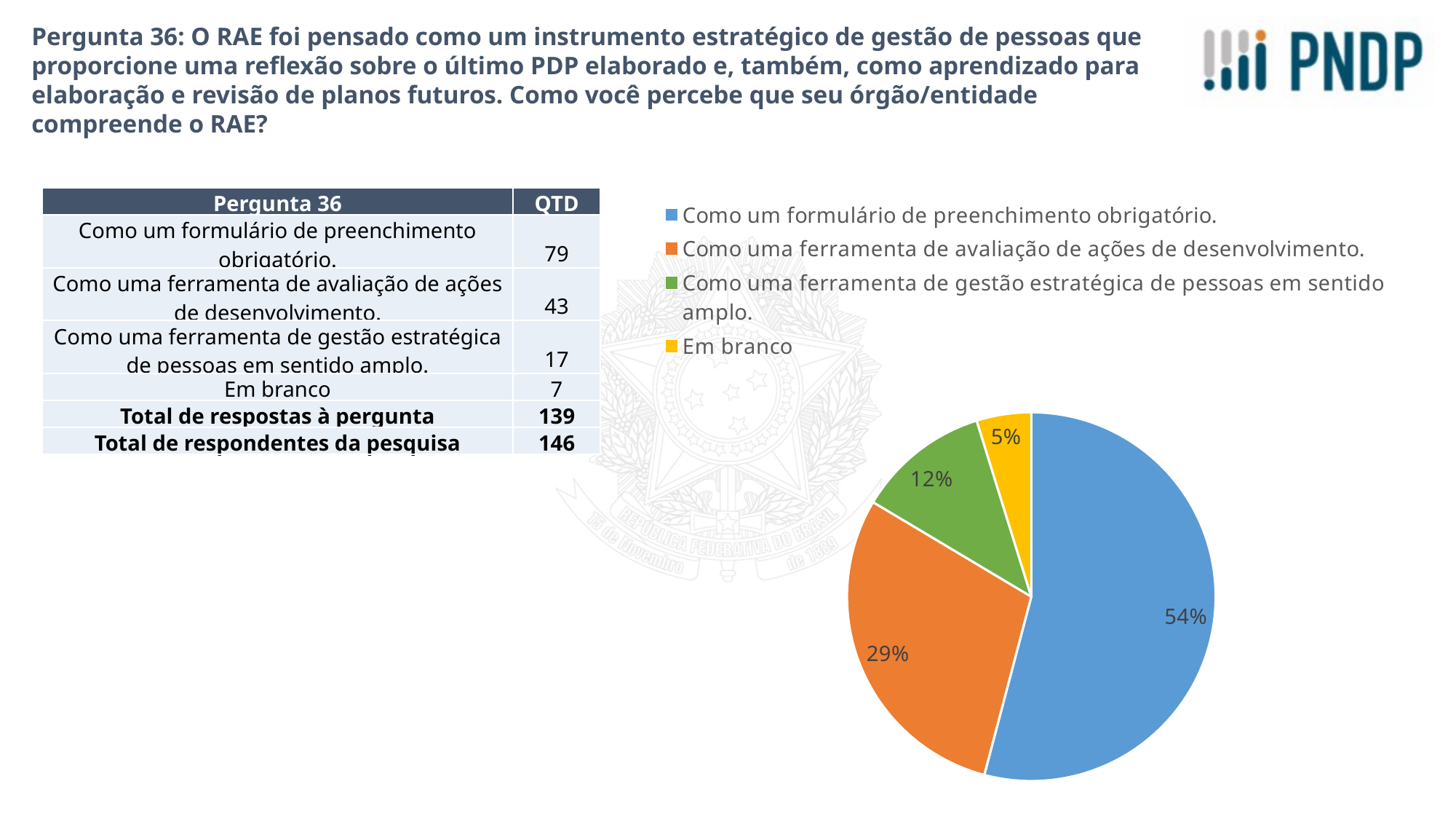
What is the difference in percentage points between the "Como um formulário de preenchimento obrigatório." slice and the "Como uma ferramenta de avaliação de ações de desenvolvimento." slice? 25 percentage points How many entries does the legend list? 4 Which category has the smallest slice of the pie? Em branco How many slices does the pie chart have? 4 What share of the pie does "Como um formulário de preenchimento obrigatório." have? 54% Which slice is larger: "Como uma ferramenta de gestão estratégica de pessoas em sentido amplo." or "Em branco"? Como uma ferramenta de gestão estratégica de pessoas em sentido amplo. Which category has the largest slice of the pie? Como um formulário de preenchimento obrigatório. What colour is the "Em branco" slice in the pie chart? yellow What share of the pie does "Como uma ferramenta de avaliação de ações de desenvolvimento." have? 29% What kind of chart is shown on the slide? pie chart What share of the pie does "Em branco" have? 5%